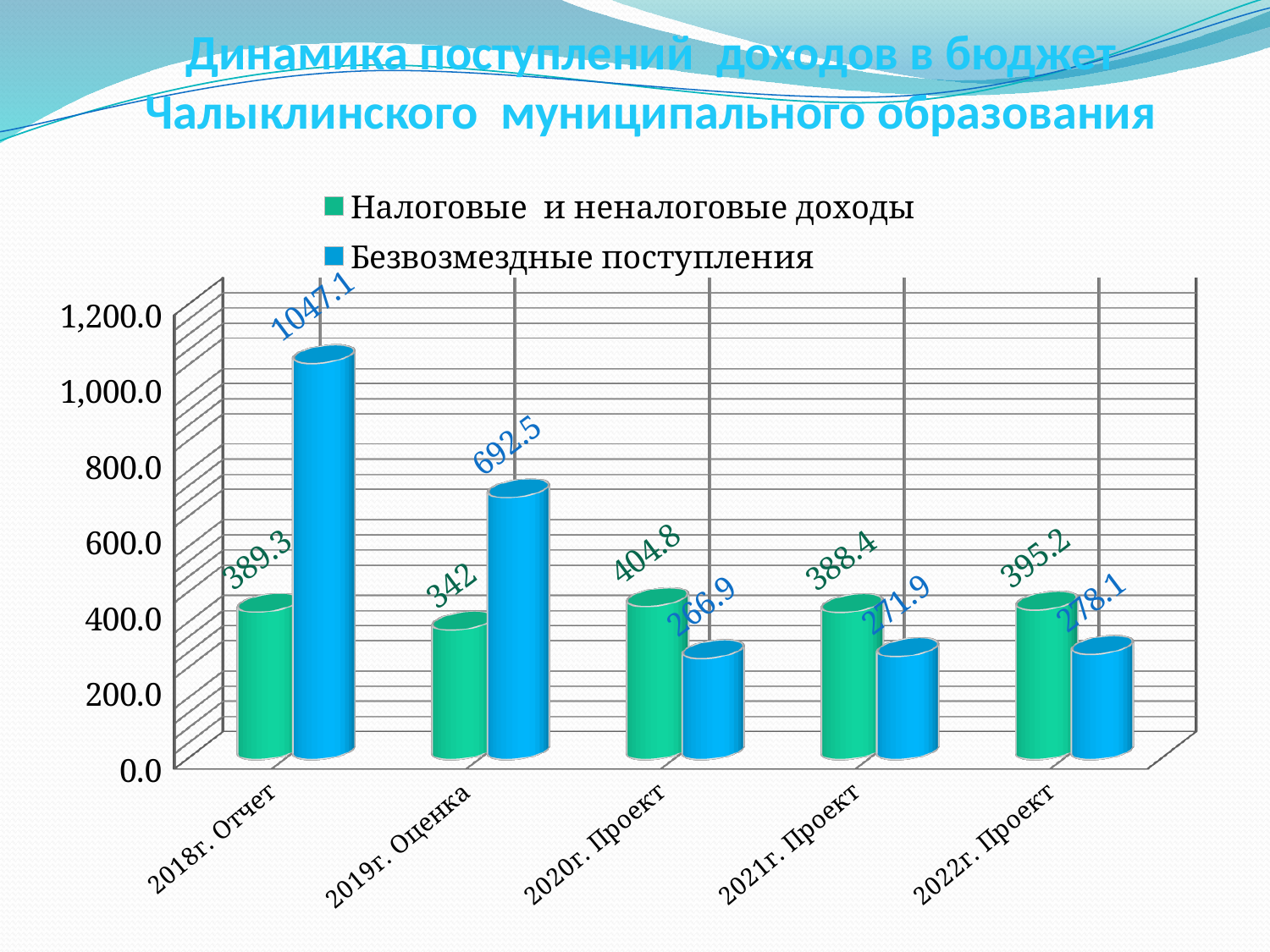
In which category is Налоговые и неналоговые доходы lowest? 2019г. Оценка What is the value of Безвозмездные поступления for 2022г. Проект? 278.1 What colour are the bars for Безвозмездные поступления? Blue Which is larger for 2020г. Проект: Налоговые и неналоговые доходы or Безвозмездные поступления? Налоговые и неналоговые доходы What kind of chart is shown on the slide? Bar chart What is the value of Безвозмездные поступления for 2018г. Отчет? 1047.1 How many categories are shown on the x axis? 5 How many series does the legend list? 2 What is the value of Налоговые и неналоговые доходы for 2019г. Оценка? 342 What is the difference between Безвозмездные поступления in 2018г. Отчет and 2019г. Оценка? 354.6 In which category is Безвозмездные поступления highest? 2018г. Отчет Does Безвозмездные поступления rise or fall from 2018г. Отчет to 2020г. Проект? Fall